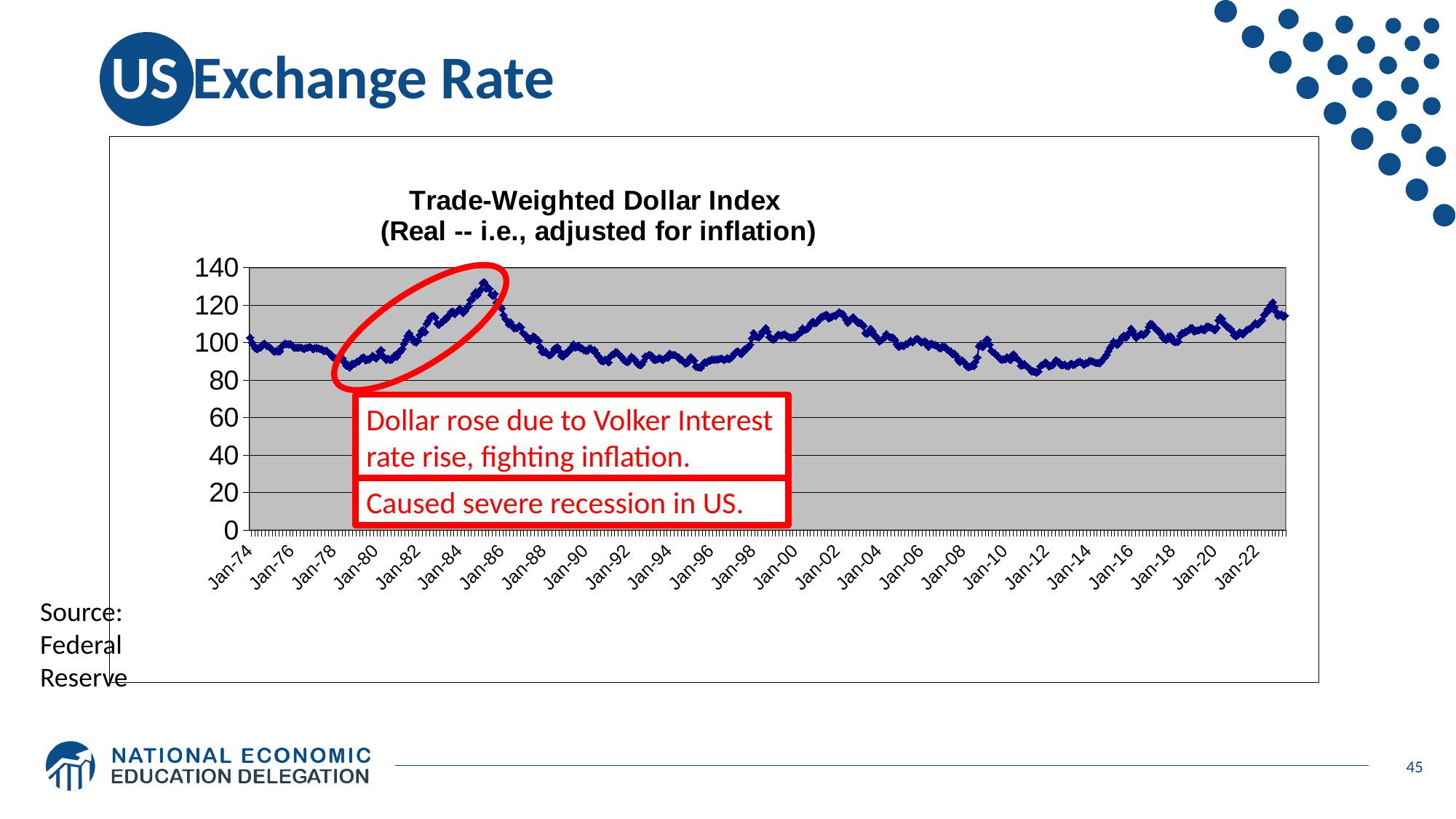
What is the highest value shown on the vertical axis of the chart? 140 What is the title of the chart? Trade-Weighted Dollar Index (Real -- i.e., adjusted for inflation) Is the value of the index at Jan-74 greater or less than 80? greater Around which x-axis label does the Trade-Weighted Dollar Index reach its highest peak? Jan-86 What kind of chart is shown on the slide? line chart Is the value of the index around Jan-12 greater or less than 100? less Is the peak value of the index around Jan-86 greater or less than 120? greater How many year labels are shown along the x axis of the chart? 25 Does the index rise or fall between Jan-80 and Jan-85? rise Does the index rise or fall between Jan-86 and Jan-88? fall Which is higher, the index value around Jan-86 or the index value around Jan-12? Jan-86